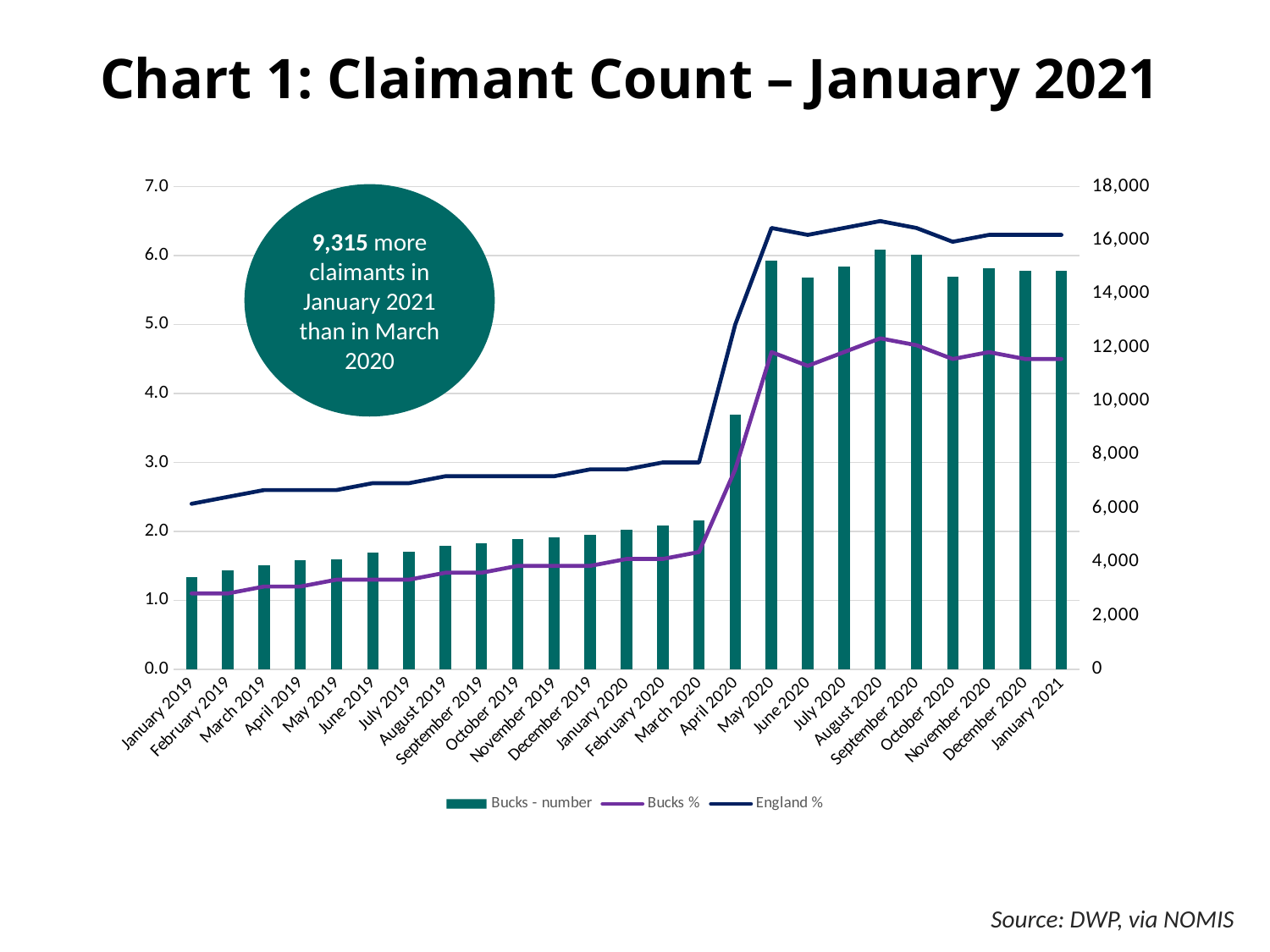
In January 2021, which line is higher: Bucks % or England %? England % According to the callout on the chart, how many more claimants were there in January 2021 than in March 2020? 9,315 Is the Bucks - number value for March 2020 greater or less than 8,000? less What kind of chart is shown on the slide? A combined bar and line chart In which month is the Bucks - number bar lowest? January 2019 Is the England % value for May 2020 greater or less than 6.0? greater In which month is the Bucks - number bar highest? August 2020 Is the Bucks % value for March 2020 greater or less than 2.0? less How many series does the legend list? 3 Do the Bucks - number bars rise or fall from January 2019 to March 2020? rise How many months are plotted along the x axis? 25